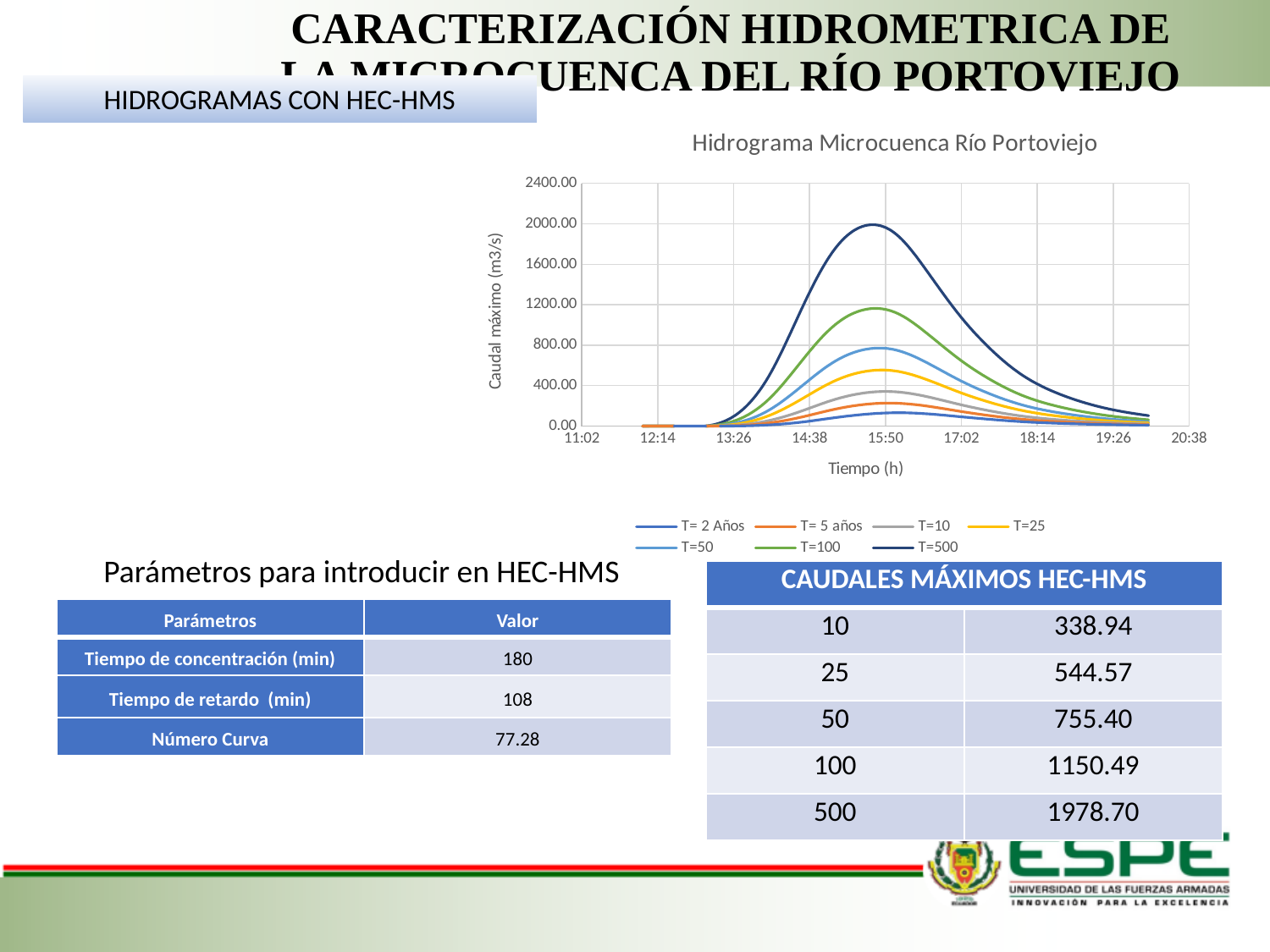
Which series reaches the highest peak in the chart? T=500 Which series has a higher peak, T=100 or T=50? T=100 How many series does the chart legend list? 7 Which series has the lowest peak in the chart? T= 2 Años What is the label of the vertical axis of the chart? Caudal máximo (m3/s) Is the peak value of the T=25 series greater or less than 400? greater What is the title of the chart? Hidrograma Microcuenca Río Portoviejo Is the peak value of the T=10 series greater or less than 400? less What kind of chart is shown on the slide? line chart Is the peak value of the T=500 series greater or less than 1600? greater Between 15:50 and 17:02, do the values of the T=500 series rise or fall? fall